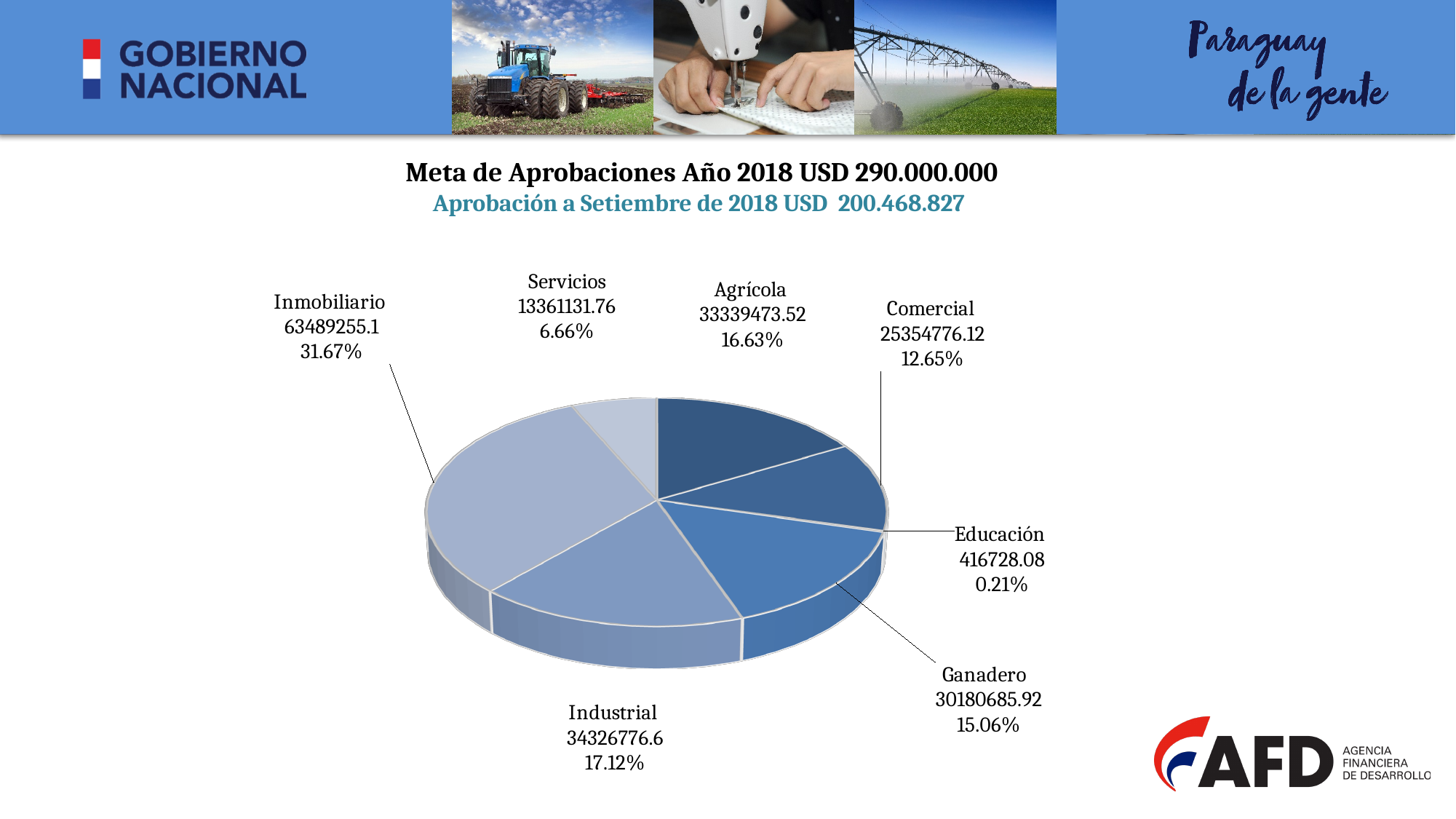
What is the difference in percentage share between Inmobiliario and Industrial? 14.55% What is the value shown for Inmobiliario? 63489255.1 What is the title shown above the chart in bold? Meta de Aprobaciones Año 2018 USD 290.000.000 What kind of chart is shown on the slide? pie chart What is the difference between the values for Industrial and Agrícola? 987303.08 What is the value shown for Educación? 416728.08 Which is larger, the value for Ganadero or the value for Comercial? Ganadero How many categories (slices) does the pie chart show? 7 What percentage share does Agrícola have in the pie chart? 16.63% Which category has the largest slice of the pie? Inmobiliario Which category has the smallest slice of the pie? Educación What percentage share does Servicios have? 6.66%